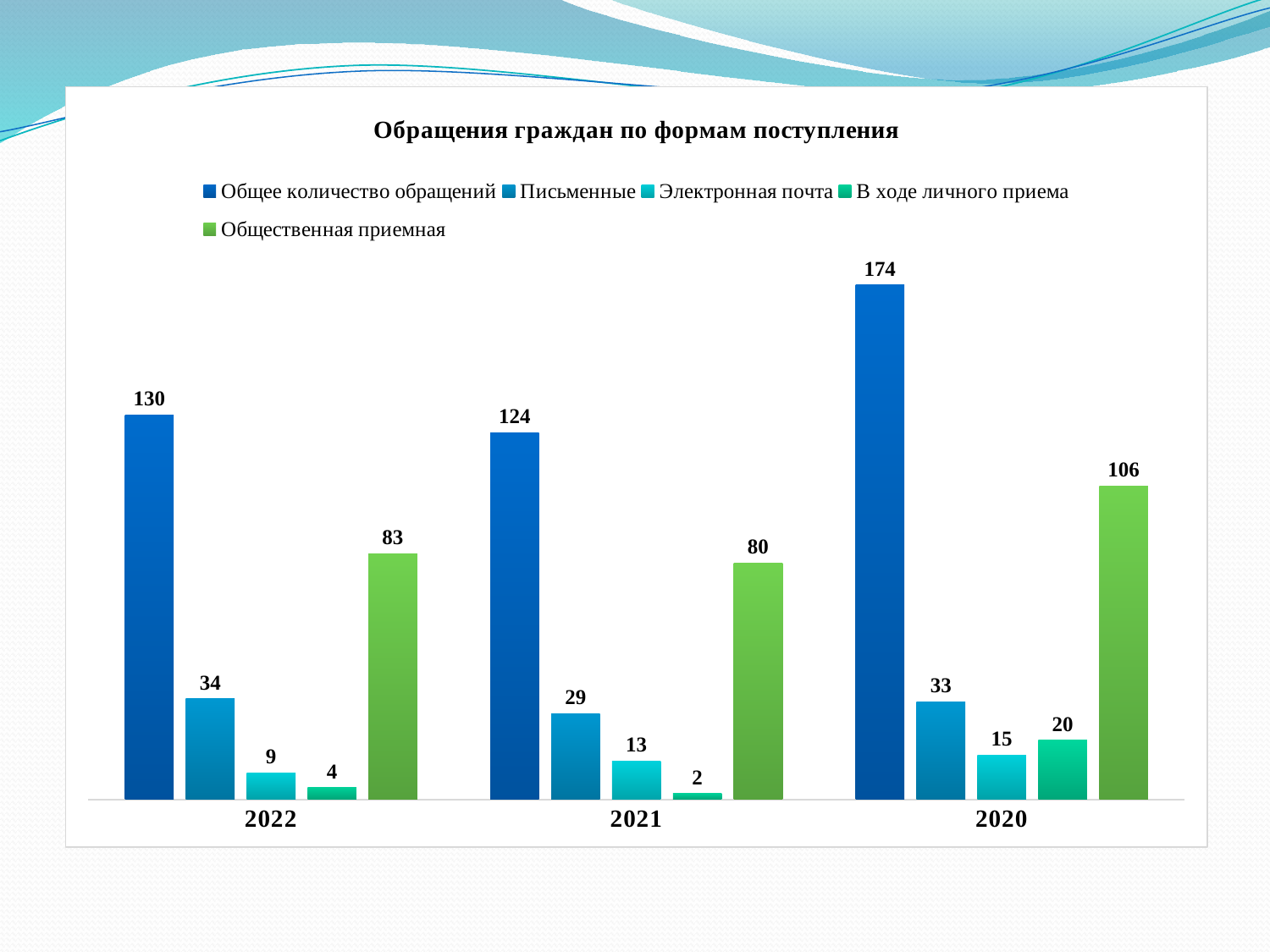
How many series does the legend list? 5 What is the value of "Общее количество обращений" for 2020? 174 What kind of chart is shown on the slide? Bar chart What is the value of "В ходе личного приема" for 2021? 2 In which year is "Электронная почта" lowest? 2022 Which is larger: "Общественная приемная" in 2022 or in 2021? 2022 How many years are shown on the x axis? 3 What is the value of "Общественная приемная" for 2021? 80 What is the title of the chart? Обращения граждан по формам поступления In which year is "Общее количество обращений" highest? 2020 What is the value of "Письменные" for 2022? 34 What is the difference between "Общее количество обращений" in 2020 and in 2022? 44